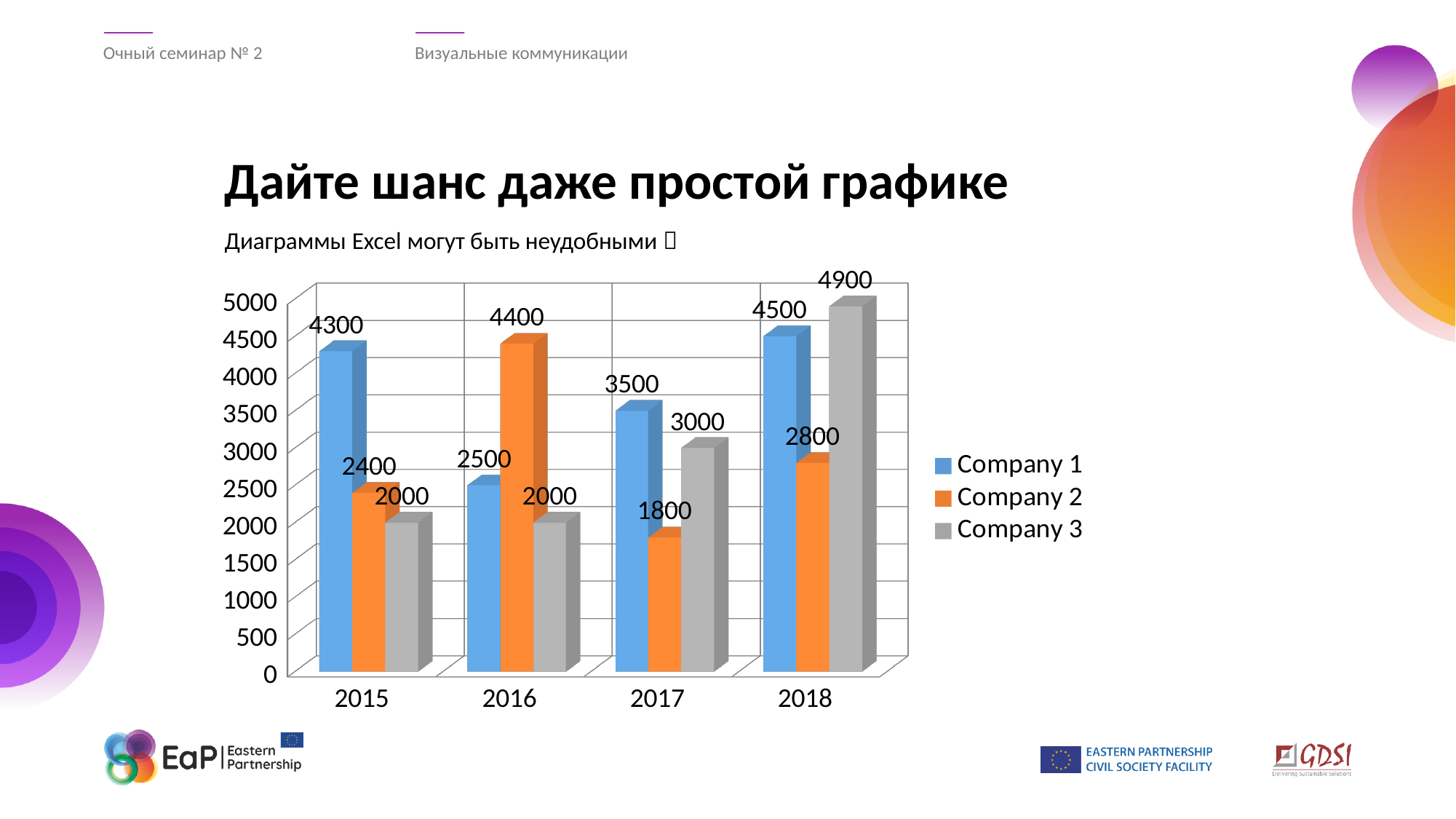
What is the value for Company 2 in 2016? 4400 In which year is the value for Company 3 highest? 2018 In which year is the value for Company 2 lowest? 2017 What is the difference between Company 1 and Company 2 in 2018? 1700 What is the value for Company 1 in 2015? 4300 Which colour represents Company 2 in the legend? Orange What kind of chart is shown on the slide? Bar chart How many series does the legend list? 3 Which is larger in 2016: Company 1 or Company 2? Company 2 How many years are shown on the x axis? 4 What is the value for Company 2 in 2017? 1800 What is the value for Company 3 in 2018? 4900